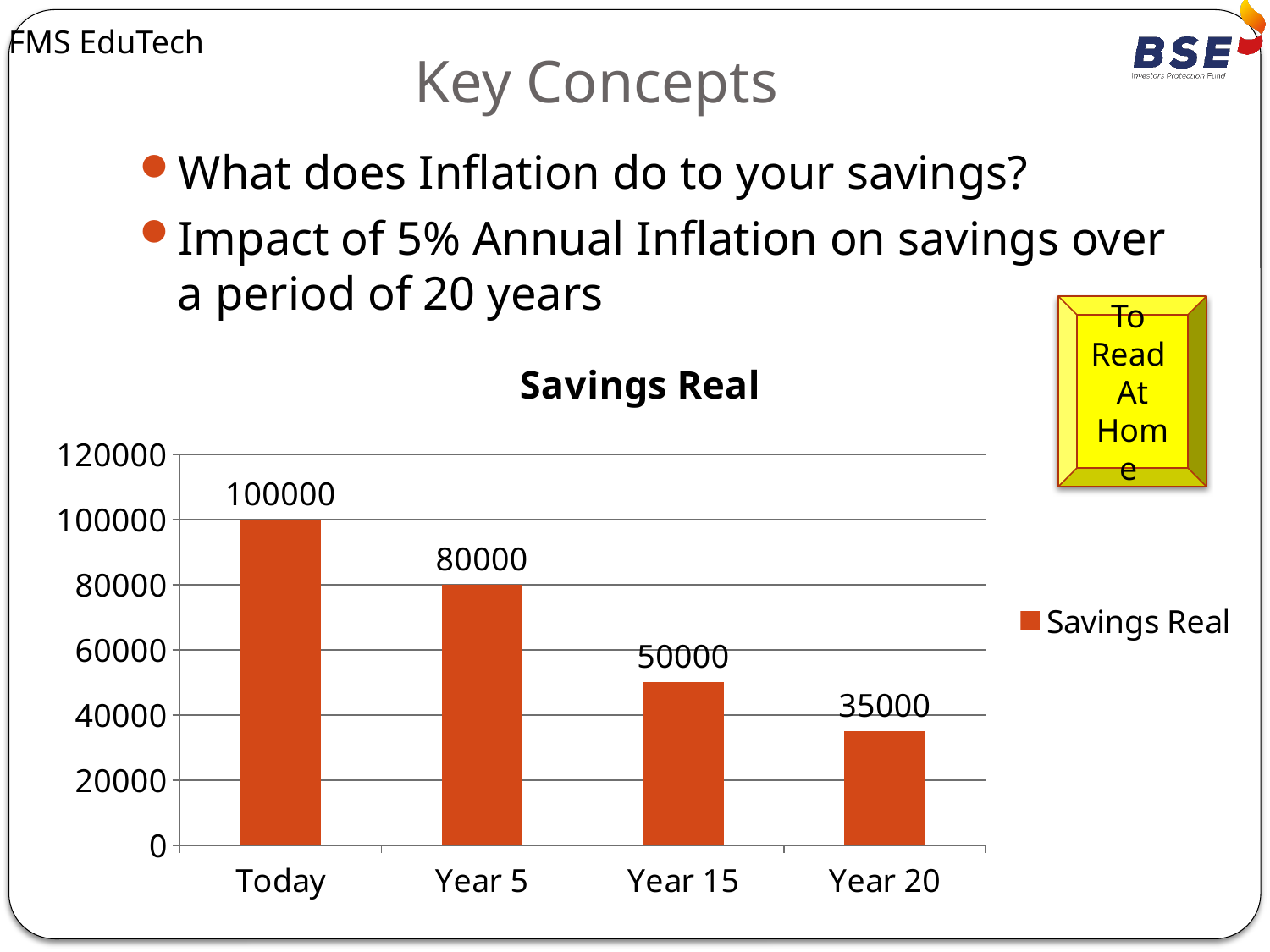
What is the value for Year 5 in the Savings Real chart? 80000 What is the value for Year 20 in the Savings Real chart? 35000 Which is larger, the value for Year 5 or the value for Year 15? Year 5 Which category has the highest value in the Savings Real chart? Today What is the value for Year 15 in the Savings Real chart? 50000 What is the value for Today in the Savings Real chart? 100000 Which category has the lowest value in the Savings Real chart? Year 20 What is the difference between the values for Year 5 and Year 15? 30000 What kind of chart is shown on the slide? Bar chart Do the values rise or fall from Today to Year 20? Fall What is the difference between the values for Today and Year 20? 65000 How many categories are shown on the x axis of the chart? 4